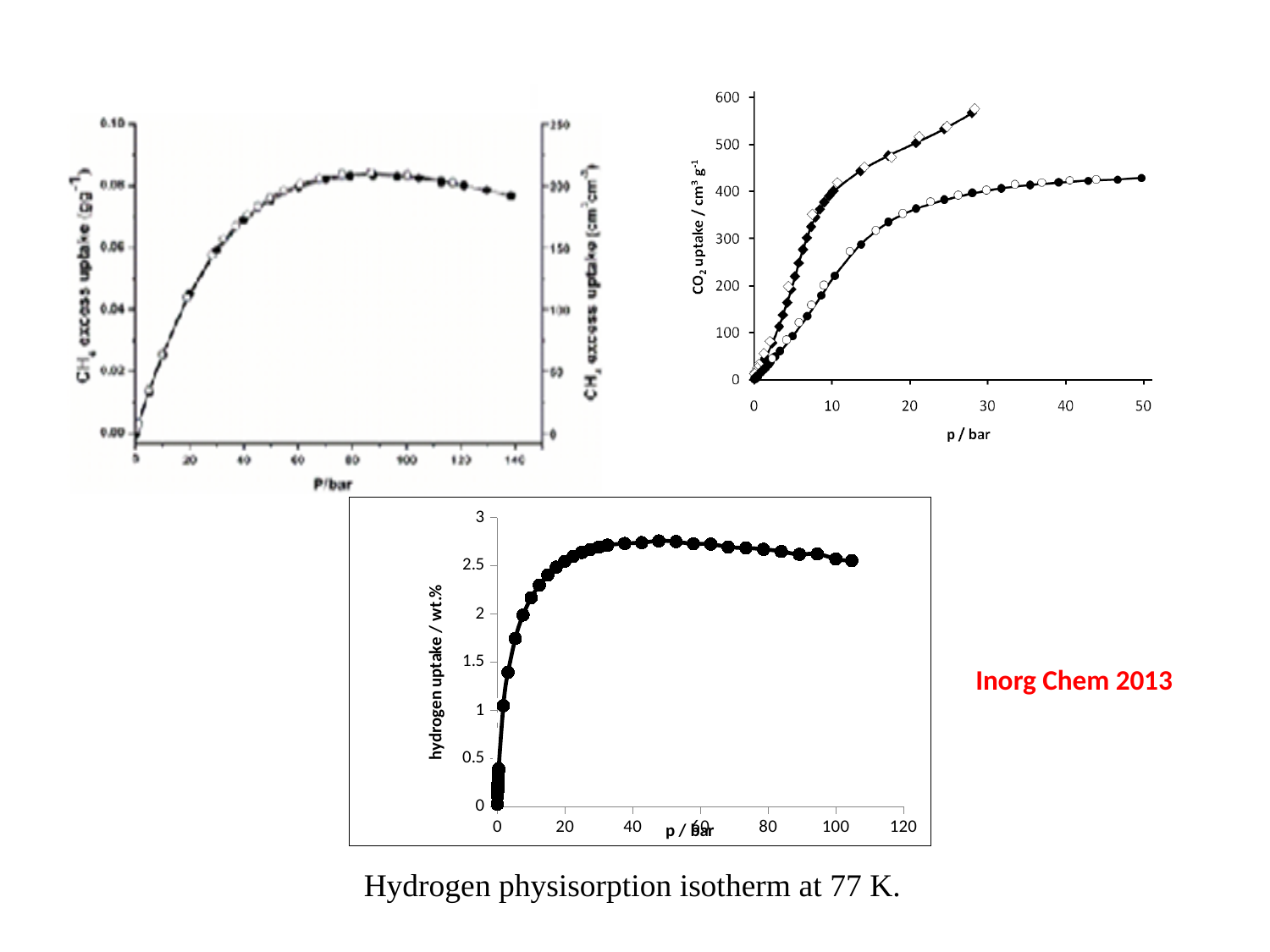
In the top-right CO2 uptake chart, is the highest value of the diamond series greater or less than 500? greater In the bottom hydrogen uptake chart, how does hydrogen uptake change as pressure increases from 0 to about 40 bar? it rises In the top-right CO2 uptake chart, what is the highest tick value on the x axis? 50 What kind of chart is the bottom chart of hydrogen uptake versus pressure? line chart In the top-left CH4 excess uptake chart, does the uptake rise or fall as pressure increases from 0 to 40 bar? rise In the bottom hydrogen uptake chart, is the hydrogen uptake at 5 bar greater or less than 1 wt.%? greater In the top-right CO2 uptake chart, how many data series are plotted? 2 What is the label of the y axis of the bottom chart? hydrogen uptake / wt.% In the bottom hydrogen uptake chart, is the maximum hydrogen uptake greater or less than 2.5 wt.%? greater In the top-right CO2 uptake chart, which series is higher at 10 bar, the diamond series or the circle series? the diamond series What is the highest tick value shown on the x axis of the bottom hydrogen uptake chart? 120